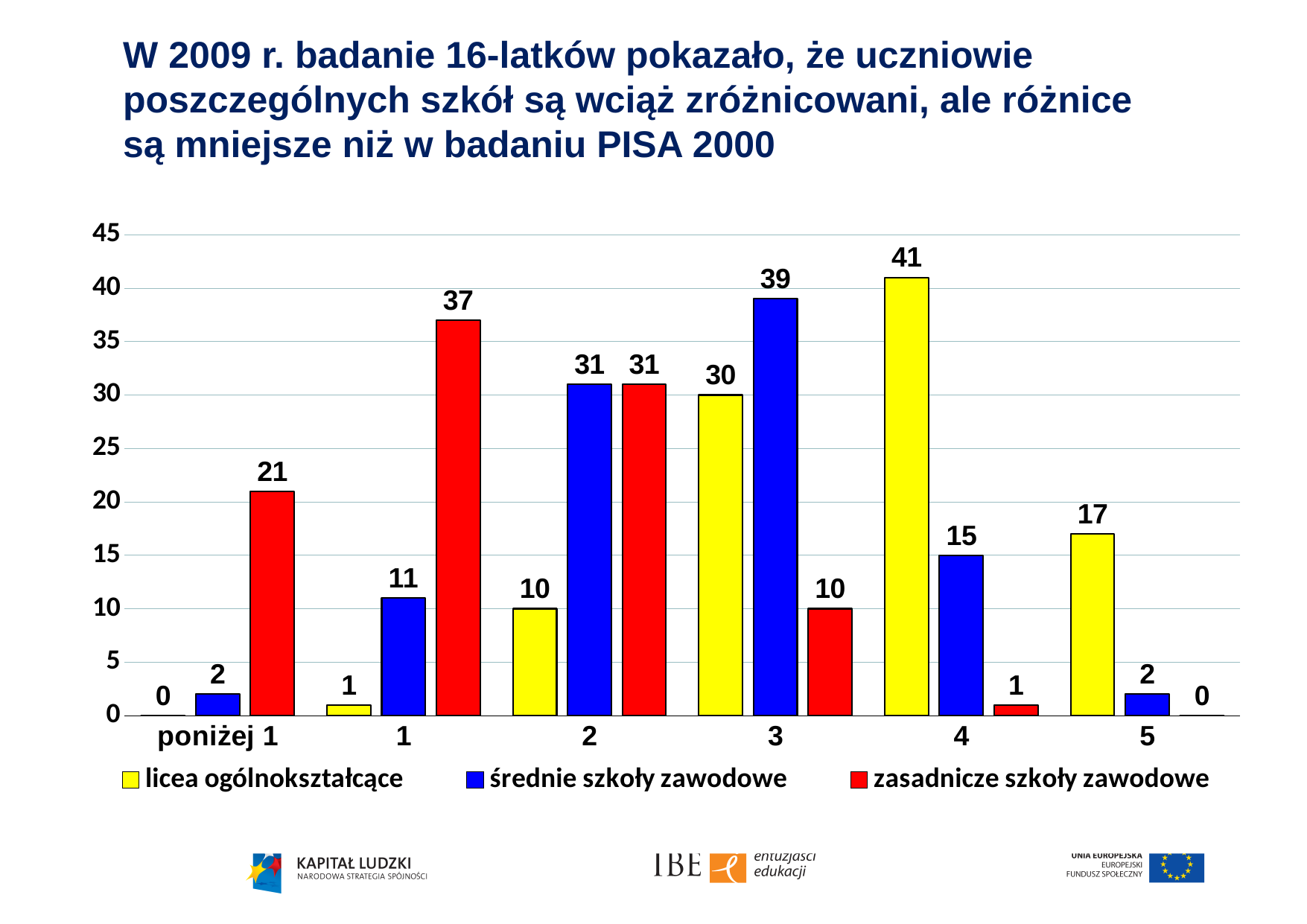
What is the value for średnie szkoły zawodowe at level 3? 39 Which colour represents zasadnicze szkoły zawodowe in the legend? red How many levels are shown on the x axis? 6 What kind of chart is shown on the slide? bar chart What is the value for licea ogólnokształcące at level 4? 41 At which level does licea ogólnokształcące reach its highest value? 4 How many series does the legend list? 3 Which is larger at level 2: średnie szkoły zawodowe or licea ogólnokształcące? średnie szkoły zawodowe What is the value for zasadnicze szkoły zawodowe at level 1? 37 What is the value for zasadnicze szkoły zawodowe at 'poniżej 1'? 21 What is the difference between średnie szkoły zawodowe and licea ogólnokształcące at level 3? 9 At which level does zasadnicze szkoły zawodowe have its lowest value? 5